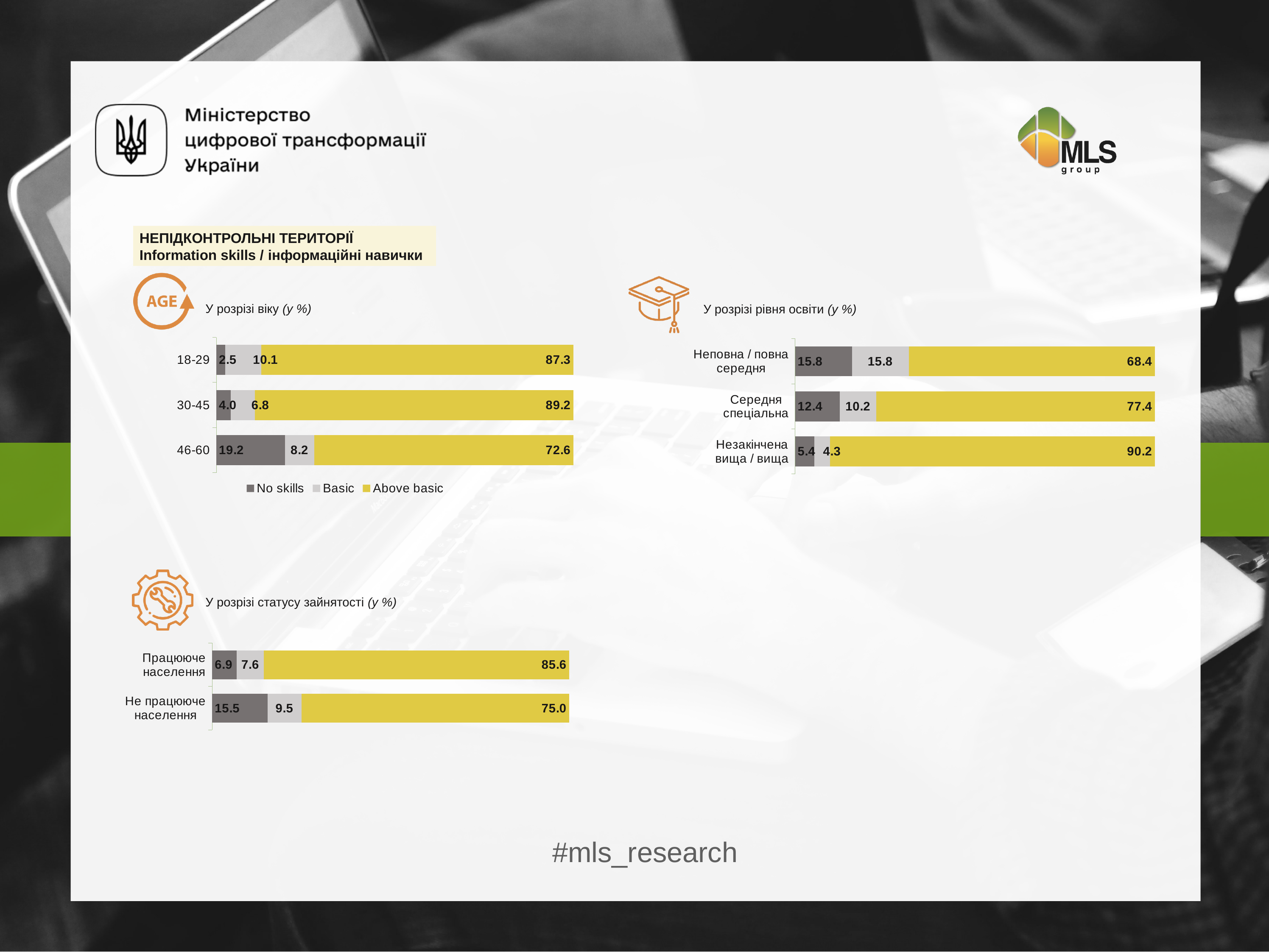
In the age chart (top left), what is the 'Above basic' value for the 18-29 group? 87.3 What type of chart is the employment status chart (bottom left)? Stacked bar chart In the age chart (top left), what is the difference between the 'Above basic' values for 30-45 and 46-60? 16.6 In the education chart (top right), how many education categories are shown? 3 In the education chart (top right), what is the 'Above basic' value for 'Незакінчена вища / вища'? 90.2 In the age chart (top left), how many series does the legend list? 3 In the employment status chart (bottom left), which group has the larger 'Above basic' value, 'Працююче населення' or 'Не працююче населення'? Працююче населення In the age chart (top left), what is the 'No skills' value for the 46-60 group? 19.2 In the education chart (top right), which education level has the lowest 'Above basic' value? Неповна / повна середня In the age chart (top left), which age group has the highest 'Above basic' value? 30-45 In the employment status chart (bottom left), what is the 'No skills' value for 'Не працююче населення'? 15.5 In the education chart (top right), what is the 'Basic' value for 'Середня спеціальна'? 10.2